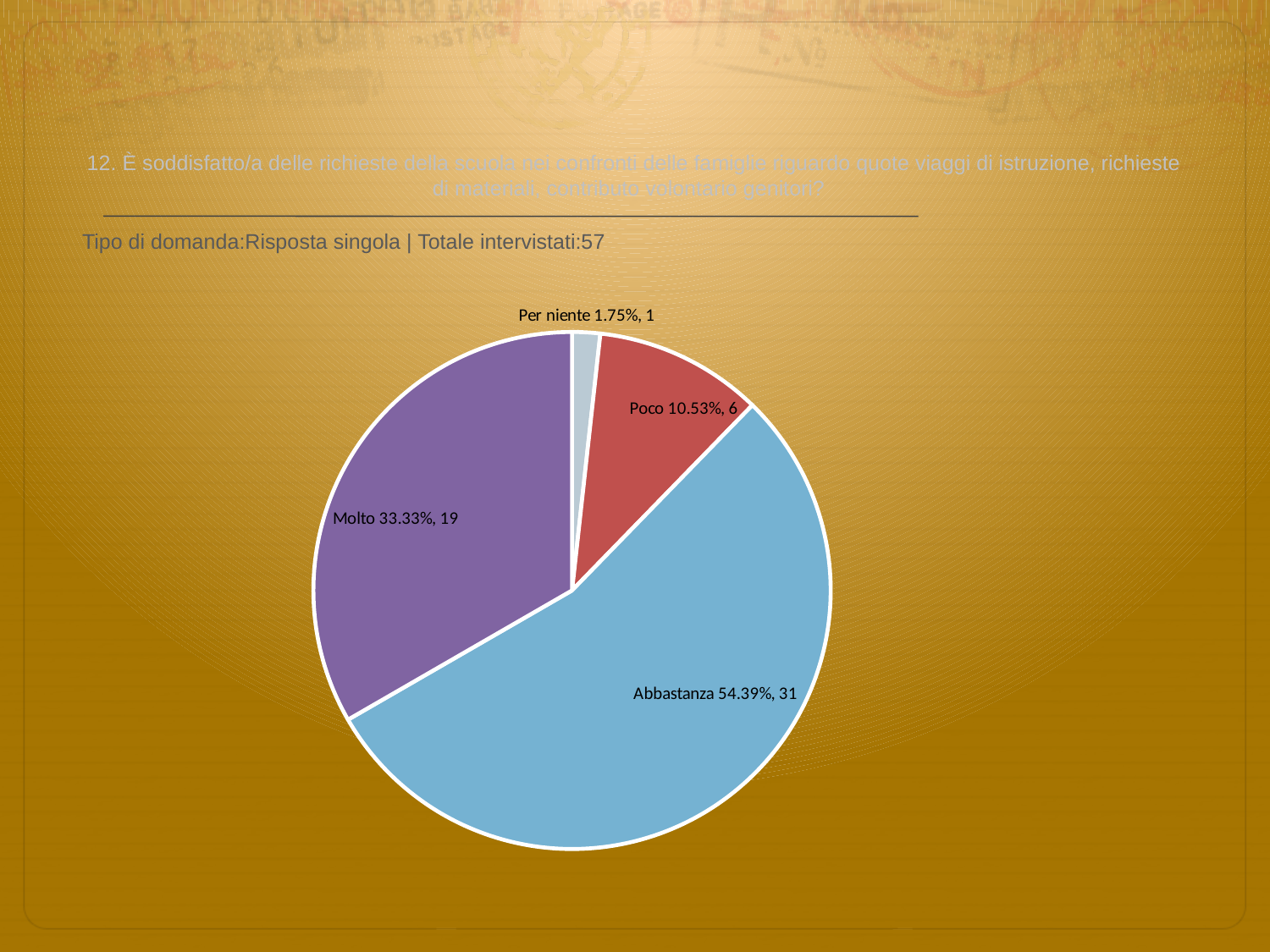
What percentage share does the Poco slice have? 10.53% What percentage share does the Abbastanza slice have? 54.39% Which is larger, the Molto slice or the Poco slice? Molto What is the total number of respondents across all slices? 57 How many respondents answered Molto? 19 What is the difference in respondent count between Abbastanza and Molto? 12 What kind of chart is shown on the slide? pie chart Which category has the smallest slice? Per niente How many respondents answered Per niente? 1 Which category has the largest slice? Abbastanza How many slices does the pie chart have? 4 What colour is the Abbastanza slice? blue